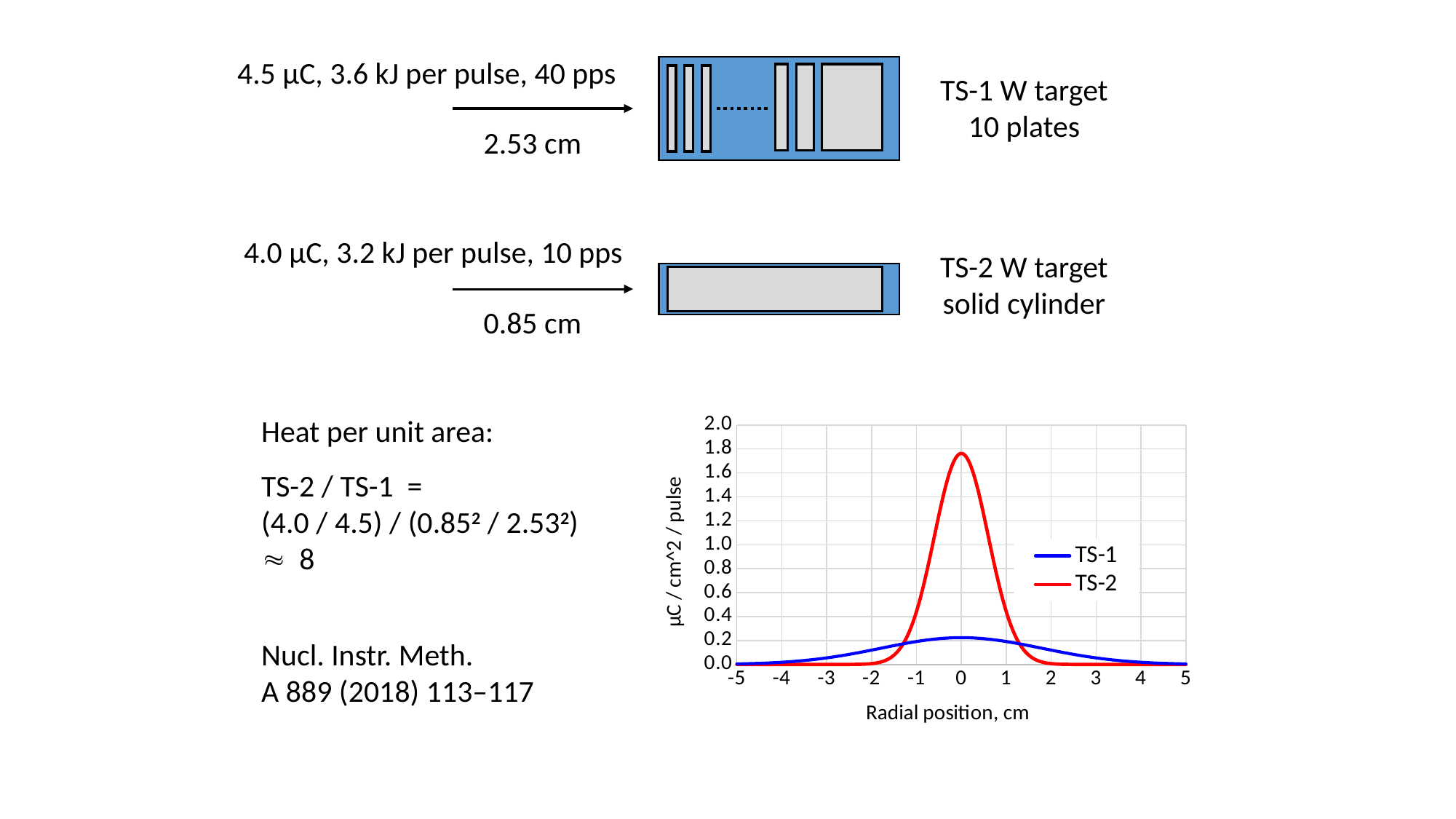
How many series does the chart legend list? 2 What is the label of the x axis of the chart? Radial position, cm What are the two series named in the chart legend? TS-1 and TS-2 Does the TS-2 curve rise or fall as radial position increases from 0 to 5 cm? fall What colour is the TS-2 line in the chart? red At radial position 3 cm, which series has the higher value, TS-1 or TS-2? TS-1 Is the value of TS-2 at radial position 2 cm greater or less than 0.2? less Does the TS-1 curve rise or fall as radial position increases from -5 to 0 cm? rise At radial position 0 cm, which series has the higher value, TS-1 or TS-2? TS-2 Is the peak value of TS-2 at radial position 0 greater or less than 1.6? greater Is the peak value of TS-1 at radial position 0 greater or less than 0.4? less What kind of chart is shown on the slide? line chart